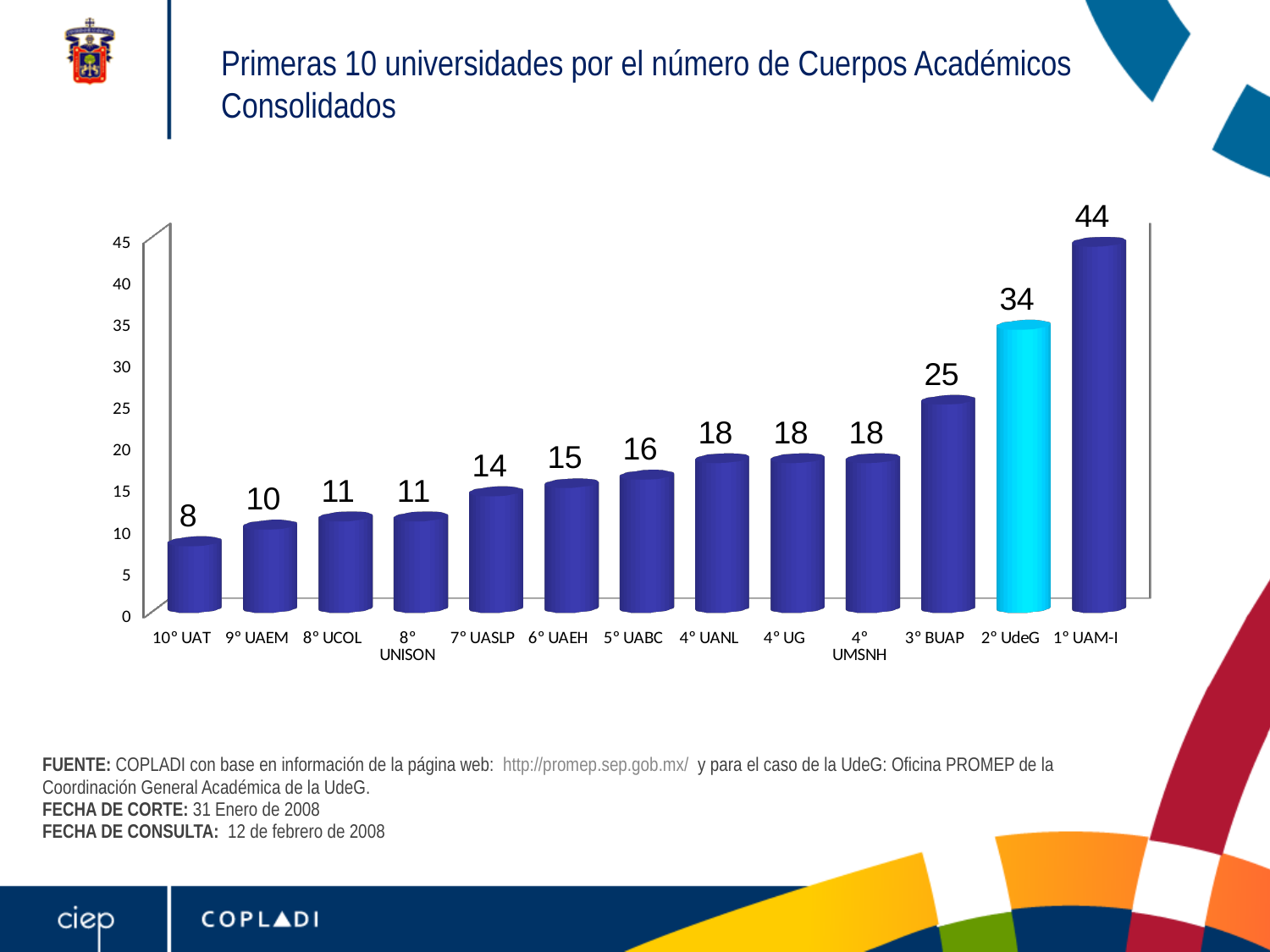
Is the value for 3° BUAP greater or less than 20? greater How many universities are shown on the chart? 13 What is the value for 10° UAT? 8 What is the value for 3° BUAP? 25 Which university has the lowest value on the chart? 10° UAT Do the values rise or fall from left to right along the x axis? rise What is the difference between the values for 1° UAM-I and 2° UdeG? 10 Which university has the highest number of Cuerpos Académicos Consolidados? 1° UAM-I What kind of chart is shown on the slide? bar chart Which is larger, the value for 7° UASLP or the value for 5° UABC? 5° UABC Which bar is shown in a different colour (light blue) from the others? 2° UdeG What is the value for 2° UdeG? 34